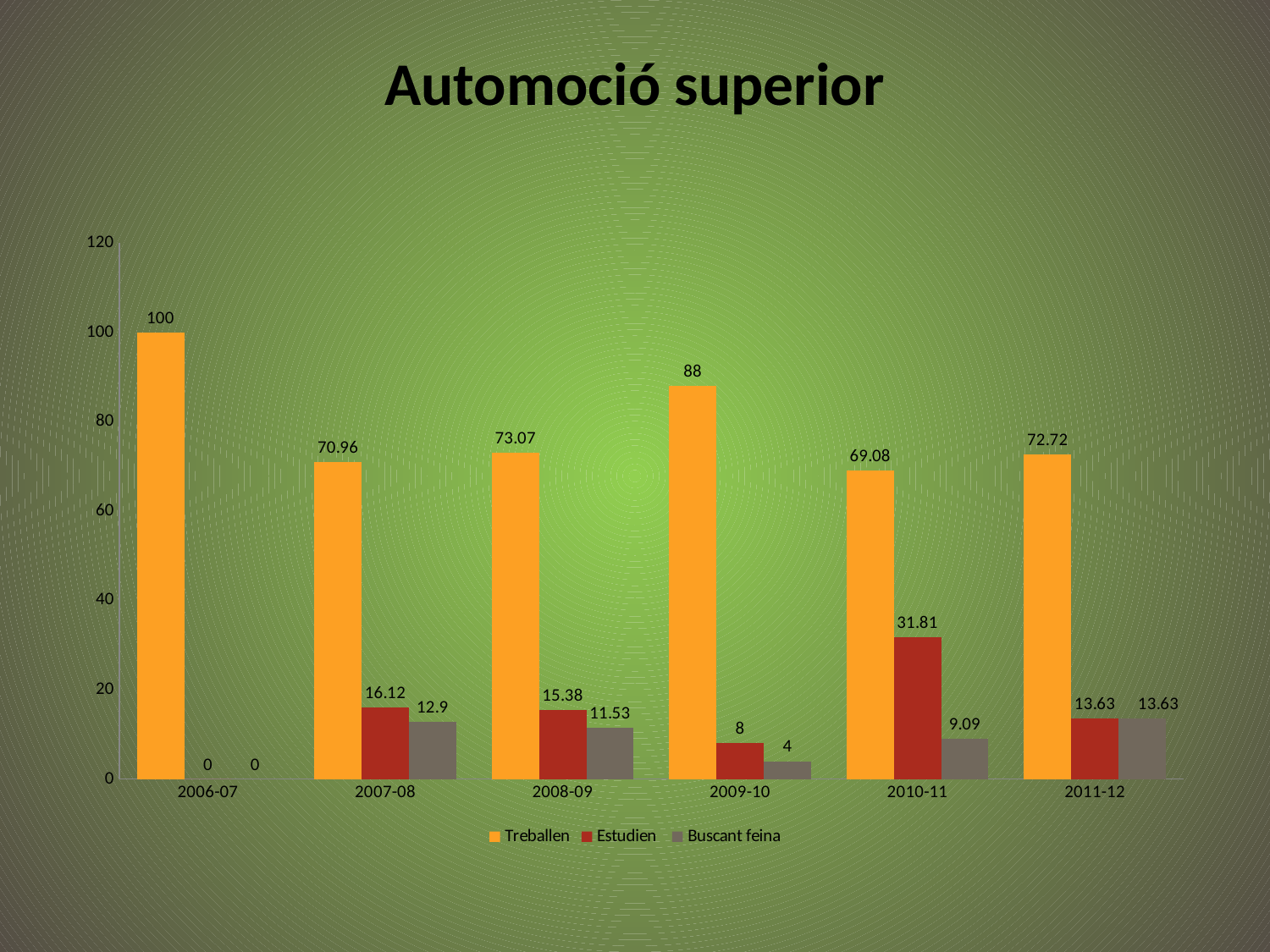
Which is larger, the Estudien value in 2008-09 or the Buscant feina value in 2008-09? Estudien In which year is the Treballen value lowest? 2010-11 What is the value for Buscant feina in 2007-08? 12.9 What is the title of the chart? Automoció superior What is the value for Estudien in 2010-11? 31.81 What kind of chart is shown on the slide? bar chart How many series does the legend list? 3 Is the Treballen value for 2011-12 greater or less than 80? less How many year categories are shown on the x axis? 6 In which year is the Treballen value highest? 2006-07 What is the value for Treballen in 2009-10? 88 What is the difference between the Treballen values for 2006-07 and 2009-10? 12